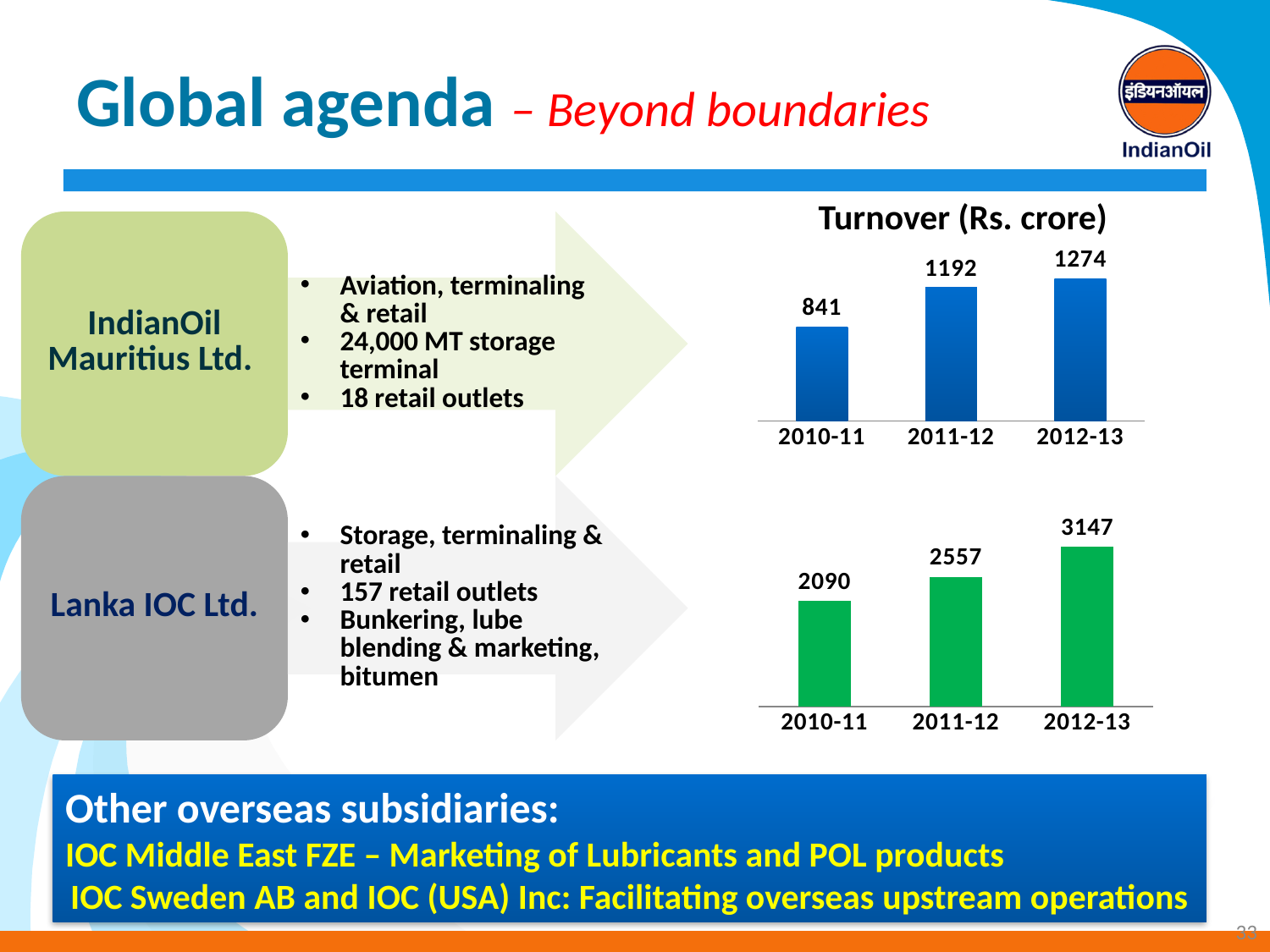
In the bottom chart (Lanka IOC Ltd. turnover), what is the difference between the 2012-13 and 2010-11 values? 1057 In the top chart (IndianOil Mauritius Ltd. turnover), what is the value for 2012-13? 1274 Which is larger: the 2012-13 value in the top chart (IndianOil Mauritius Ltd.) or the 2010-11 value in the bottom chart (Lanka IOC Ltd.)? 2010-11 value in the bottom chart (Lanka IOC Ltd.) In the top chart (IndianOil Mauritius Ltd. turnover), which year has the lowest value? 2010-11 What is the title shown above the top chart? Turnover (Rs. crore) In the top chart (IndianOil Mauritius Ltd. turnover), what is the value for 2010-11? 841 What kind of chart is the top chart (IndianOil Mauritius Ltd. turnover)? Bar chart In the top chart (IndianOil Mauritius Ltd. turnover), what is the difference between the 2011-12 and 2010-11 values? 351 In the bottom chart (Lanka IOC Ltd. turnover), which year has the highest value? 2012-13 In the bottom chart (Lanka IOC Ltd. turnover), what is the value for 2011-12? 2557 How many bars are in the bottom chart (Lanka IOC Ltd. turnover)? 3 In the bottom chart (Lanka IOC Ltd. turnover), do the values rise or fall from 2010-11 to 2012-13? Rise